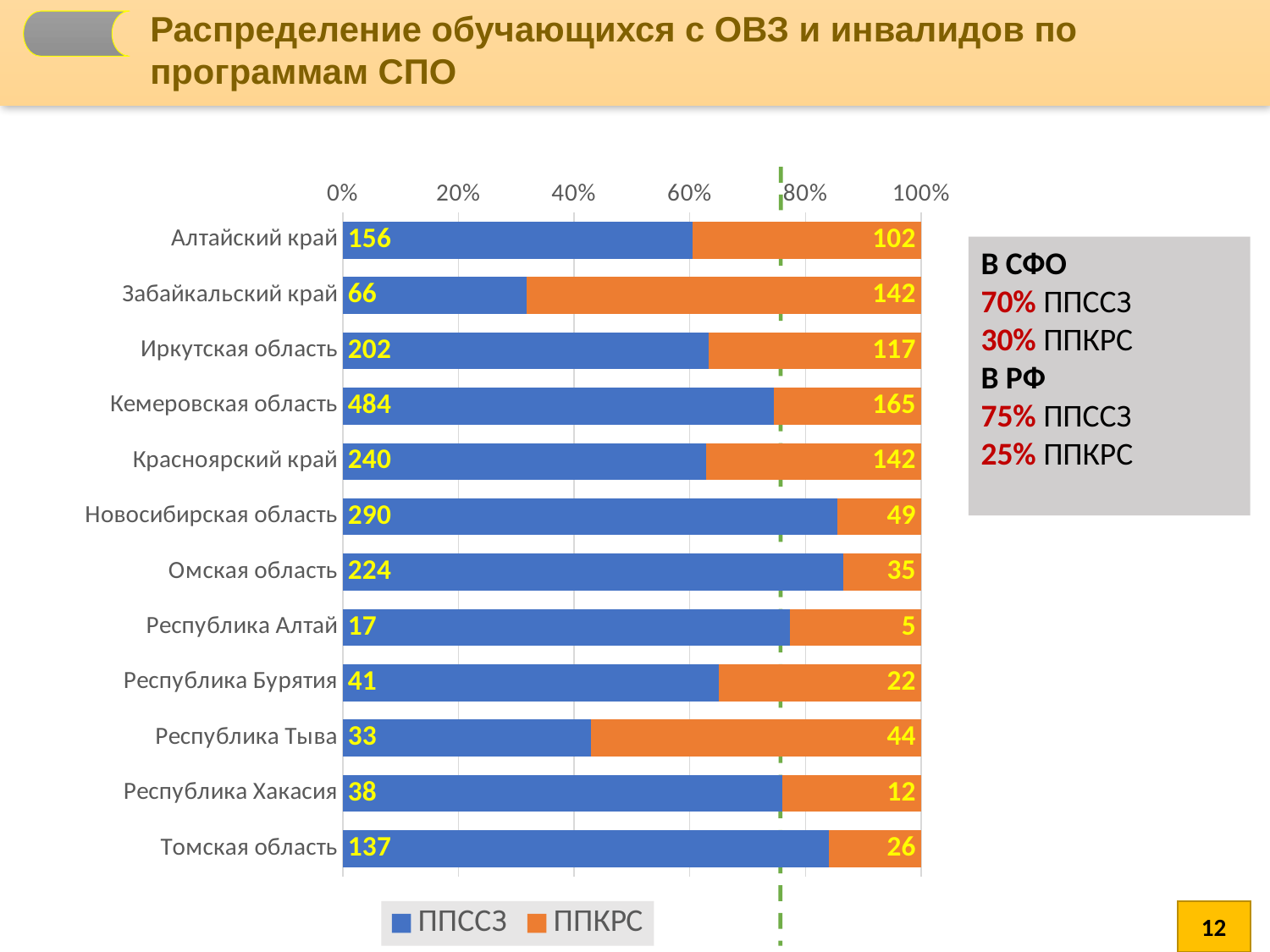
Which region has the lowest ППКРС value? Республика Алтай How many regions are shown in the chart? 12 Which region has the highest ППССЗ value? Кемеровская область Which is larger for Республика Тыва: the ППССЗ value or the ППКРС value? ППКРС How many series does the legend list? 2 Is the ППССЗ share of the bar for Забайкальский край greater or less than 40%? less What is the ППССЗ value for Томская область? 137 Is the ППССЗ share of the bar for Новосибирская область greater or less than 80%? greater How many students are in the ППССЗ series for Кемеровская область? 484 What is the ППКРС value for Забайкальский край? 142 What is the total number of students (ППССЗ plus ППКРС) for Омская область? 259 What is the difference between the ППССЗ and ППКРС values for Алтайский край? 54